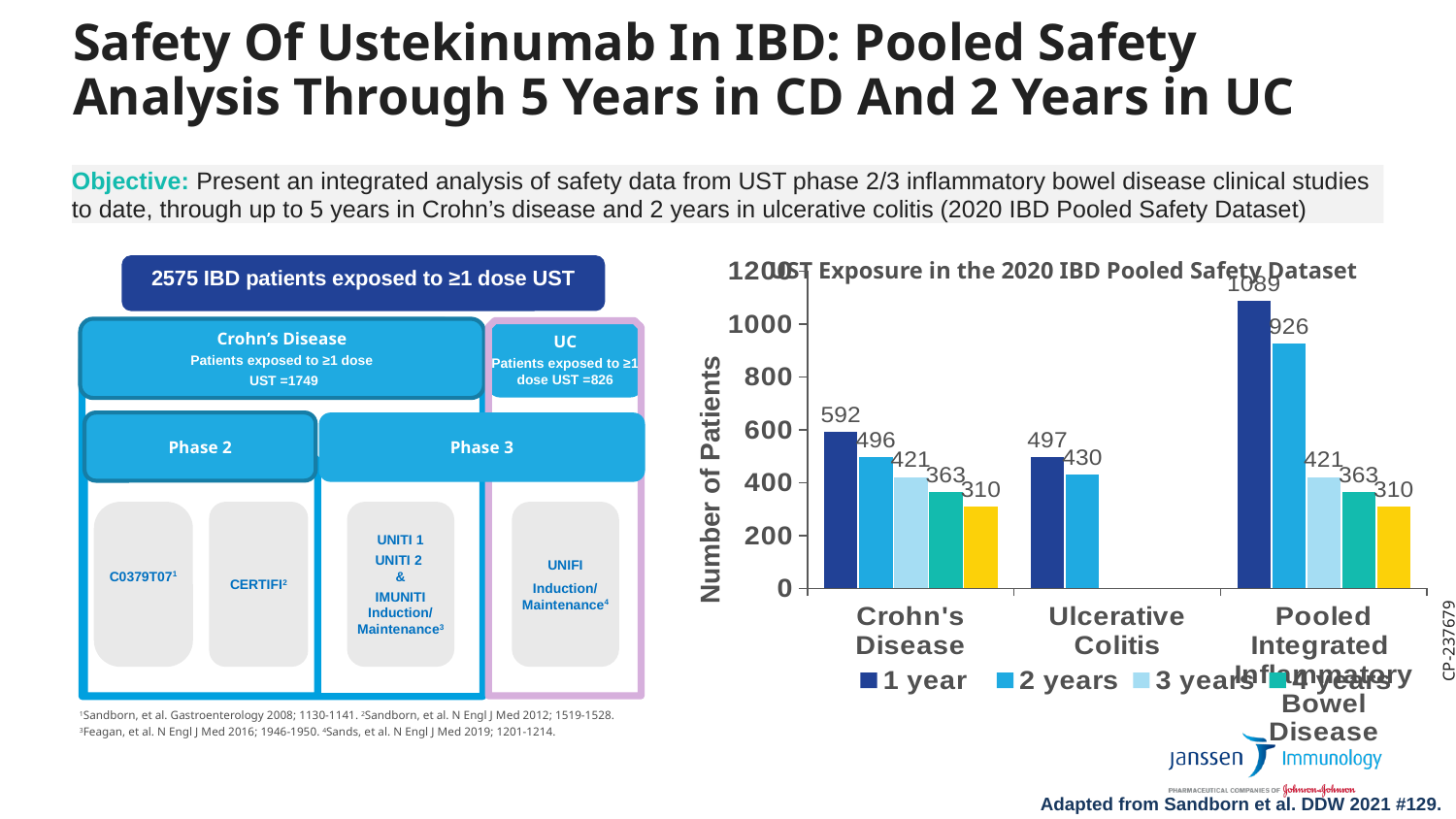
What is the 1 year value for Pooled Integrated Inflammatory Bowel Disease? 1089 What is the 2 years value for Ulcerative Colitis? 430 What type of chart is shown on the slide? bar chart Which category has the lowest 2 years value? Ulcerative Colitis What is the title of the chart? UST Exposure in the 2020 IBD Pooled Safety Dataset What is the 1 year value for Crohn's Disease? 592 What is the difference between the 1 year values for Pooled Integrated Inflammatory Bowel Disease and Crohn's Disease? 497 Which is larger, the 2 years value for Crohn's Disease or the 1 year value for Ulcerative Colitis? 1 year value for Ulcerative Colitis How many categories are shown on the x axis? 3 What is the 3 years value for Crohn's Disease? 421 Which category has the highest 1 year value? Pooled Integrated Inflammatory Bowel Disease What is the difference between the 1 year and 2 years values for Crohn's Disease? 96